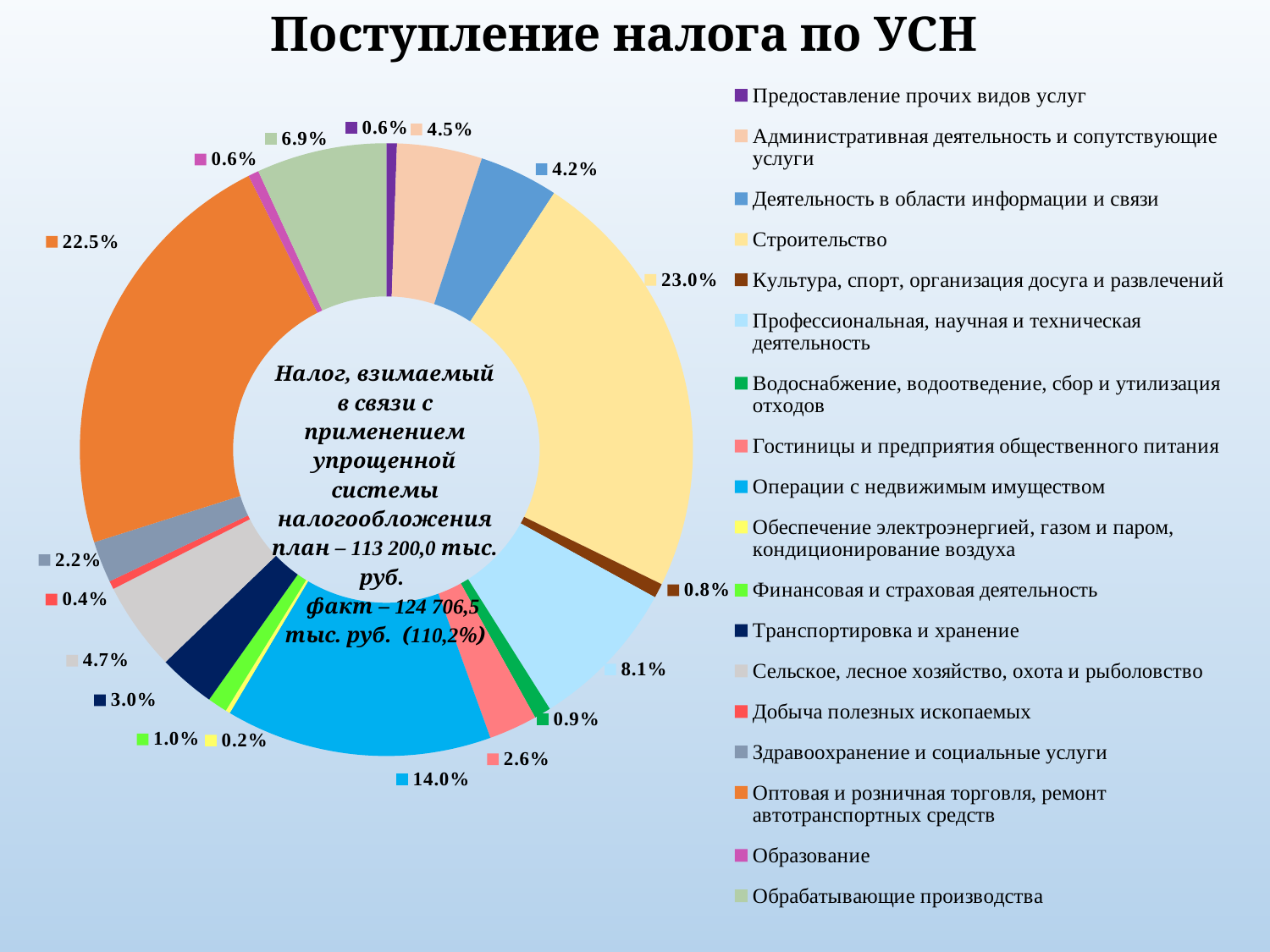
What share does Оптовая и розничная торговля, ремонт автотранспортных средств have? 22.5% What share does Строительство have? 23.0% Which category has the smallest share? Обеспечение электроэнергией, газом и паром, кондиционирование воздуха Which has a larger share: Обрабатывающие производства or Сельское, лесное хозяйство, охота и рыболовство? Обрабатывающие производства What share does Профессиональная, научная и техническая деятельность have? 8.1% Which category has the largest share? Строительство According to the text in the centre of the chart, what is the actual (факт) tax receipt amount? 124 706,5 тыс. руб. What is the title of the slide? Поступление налога по УСН How many categories does the legend list? 18 What share does Операции с недвижимым имуществом have? 14.0% What is the difference between the shares of Строительство and Оптовая и розничная торговля, ремонт автотранспортных средств? 0.5% What kind of chart is shown on the slide? Doughnut (pie) chart